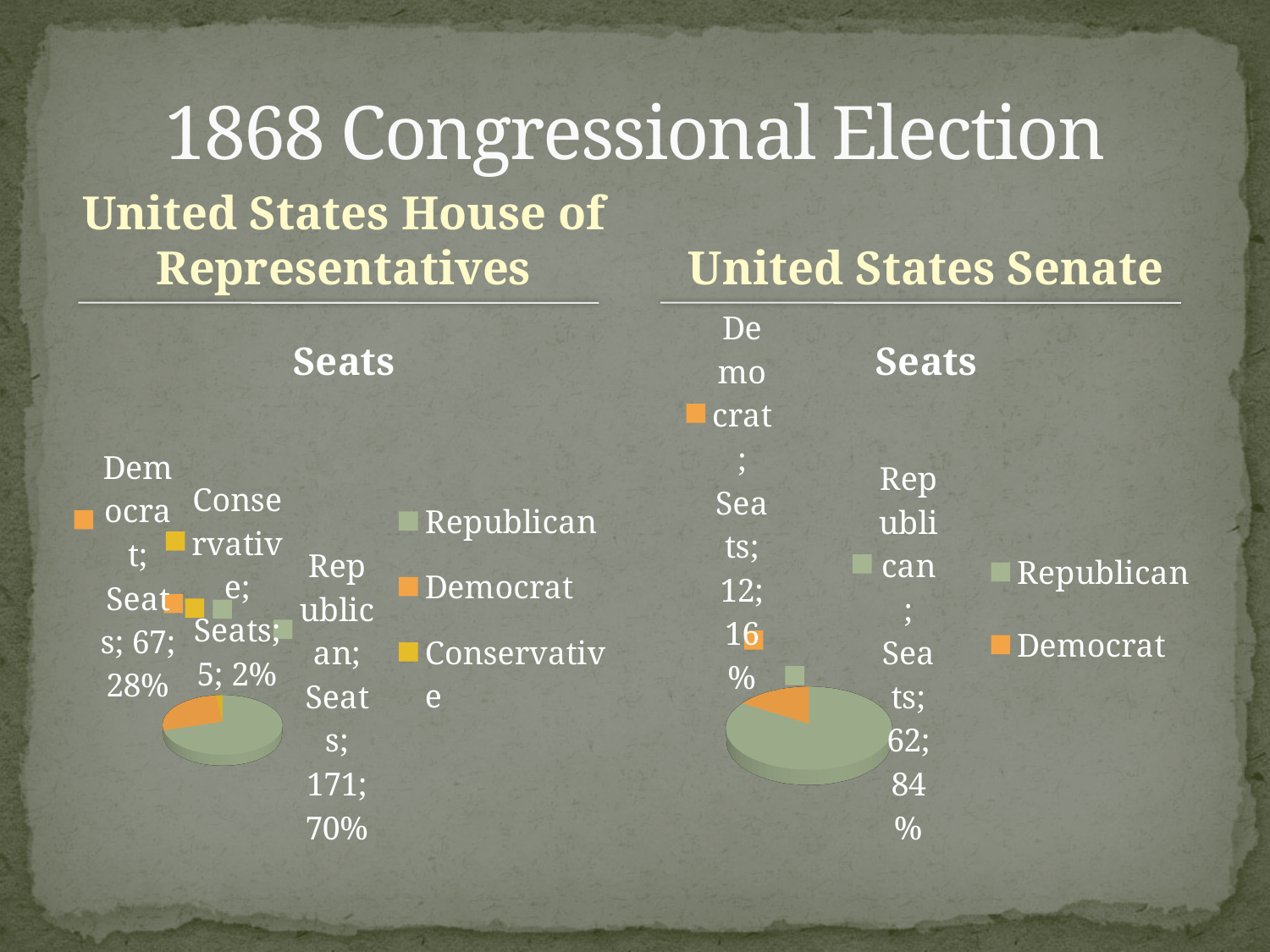
In the United States Senate chart, how many more seats did the Republicans win than the Democrats? 50 How many entries does the legend of the United States House of Representatives chart list? 3 In the United States House of Representatives chart, how many seats did the Republicans win? 171 In the United States House of Representatives chart, how many seats did the Democrats win? 67 In the United States House of Representatives chart, how many more seats did the Republicans win than the Democrats? 104 What type of chart is used for the United States Senate seats? Pie chart In the United States Senate chart, how many seats did the Democrats win? 12 In the United States House of Representatives chart, which party has the largest share of seats? Republican In the United States House of Representatives chart, which party has the smallest share of seats? Conservative In the United States House of Representatives chart, what share of seats did the Conservatives hold? 2% In the United States Senate chart, what share of seats did the Republicans hold? 84% How many parties are shown in the United States Senate chart? 2